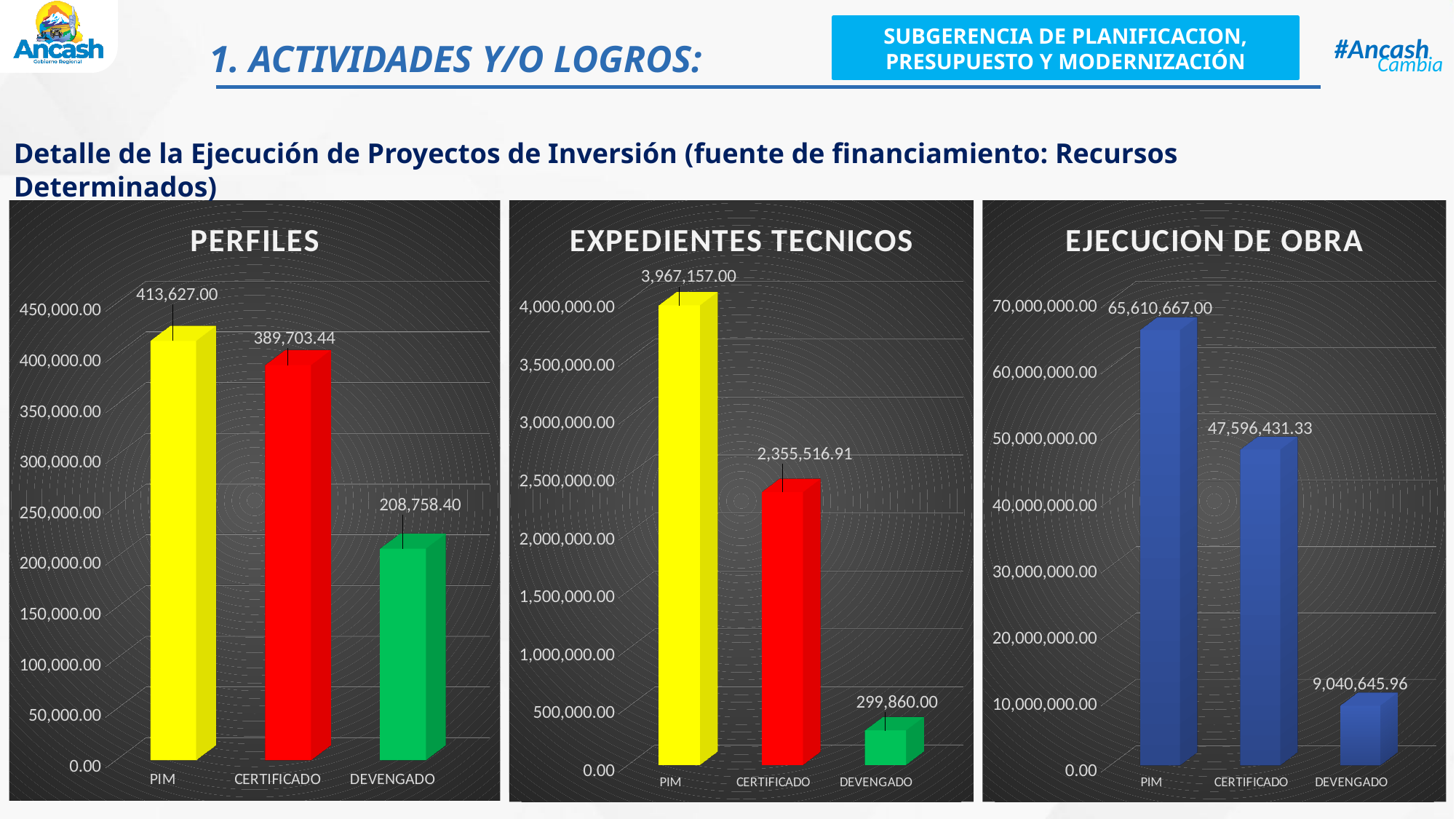
In the EJECUCION DE OBRA chart, which category has the highest value? PIM In the PERFILES chart, what is the value for DEVENGADO? 208,758.40 In the PERFILES chart, what is the value for PIM? 413,627.00 In the PERFILES chart, what is the difference between PIM and CERTIFICADO? 23,923.56 In the EXPEDIENTES TECNICOS chart, which is larger, PIM or DEVENGADO? PIM How many categories are shown in the PERFILES chart? 3 In the EJECUCION DE OBRA chart, what is the difference between PIM and CERTIFICADO? 18,014,235.67 In the EXPEDIENTES TECNICOS chart, do the values rise or fall from PIM to DEVENGADO? Fall In the EXPEDIENTES TECNICOS chart, what is the value for CERTIFICADO? 2,355,516.91 In the EJECUCION DE OBRA chart, what is the value for DEVENGADO? 9,040,645.96 What type of chart is the EJECUCION DE OBRA chart? Bar chart In the EXPEDIENTES TECNICOS chart, which category has the lowest value? DEVENGADO